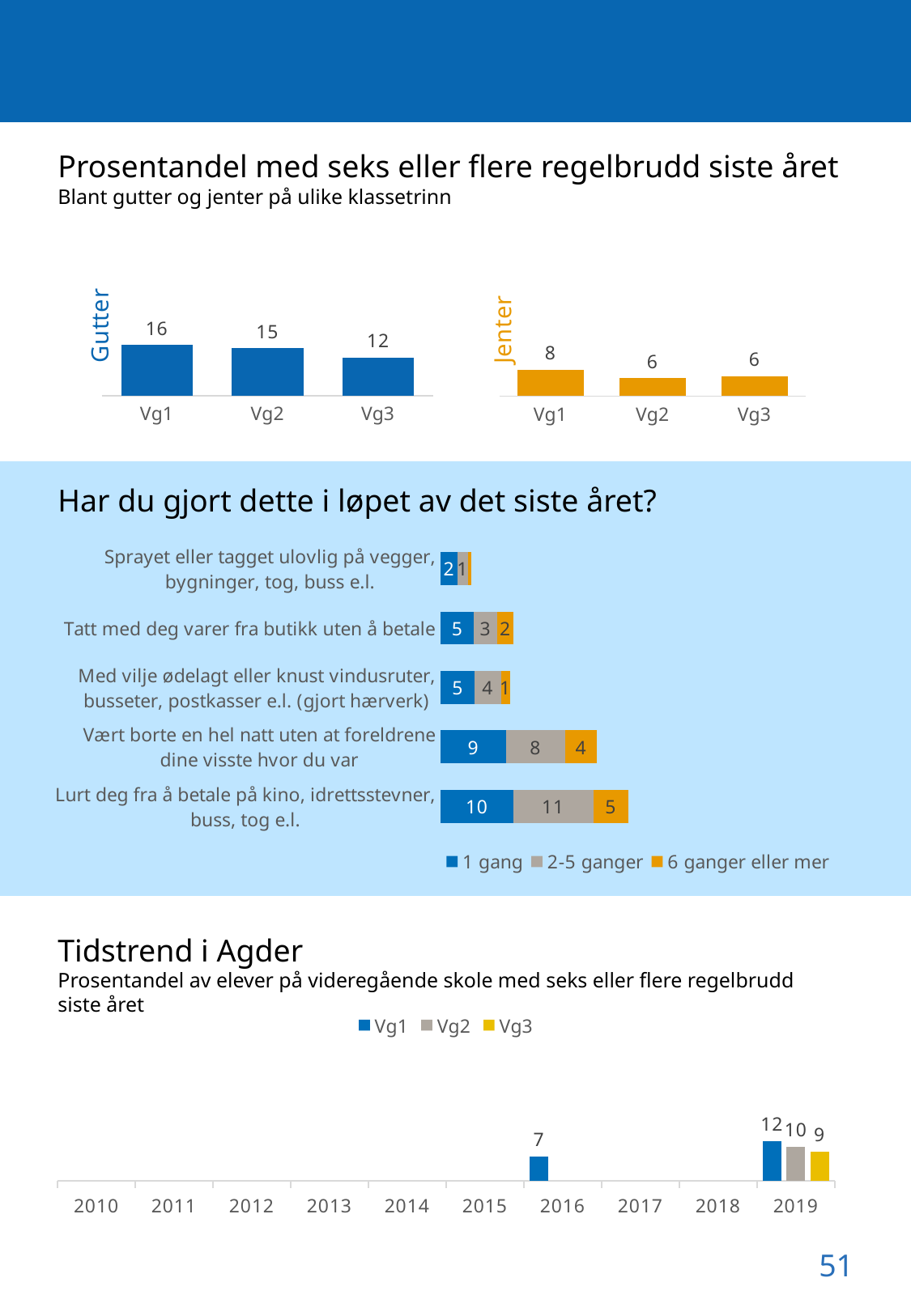
In the "Gutter" chart, what is the value for Vg1? 16 How many series does the legend of the chart "Har du gjort dette i løpet av det siste året?" list? 3 In the "Jenter" chart, what is the value for Vg1? 8 In the "Gutter" chart, do the values rise or fall from Vg1 to Vg3? fall What kind of chart is the "Tidstrend i Agder" chart? bar chart Which is larger: the Vg2 value in the "Gutter" chart or the Vg2 value in the "Jenter" chart? Gutter How many categories are shown in the chart "Har du gjort dette i løpet av det siste året?"? 5 In the "Gutter" chart, which category has the lowest value? Vg3 In the "Tidstrend i Agder" chart, what is the Vg1 value for 2019? 12 In the chart "Har du gjort dette i løpet av det siste året?", what is the "2-5 ganger" value for "Lurt deg fra å betale på kino, idrettsstevner, buss, tog e.l."? 11 In the "Gutter" chart, what is the difference between the values for Vg1 and Vg3? 4 In the chart "Har du gjort dette i løpet av det siste året?", what is the total of the stacked bar for "Vært borte en hel natt uten at foreldrene dine visste hvor du var"? 21